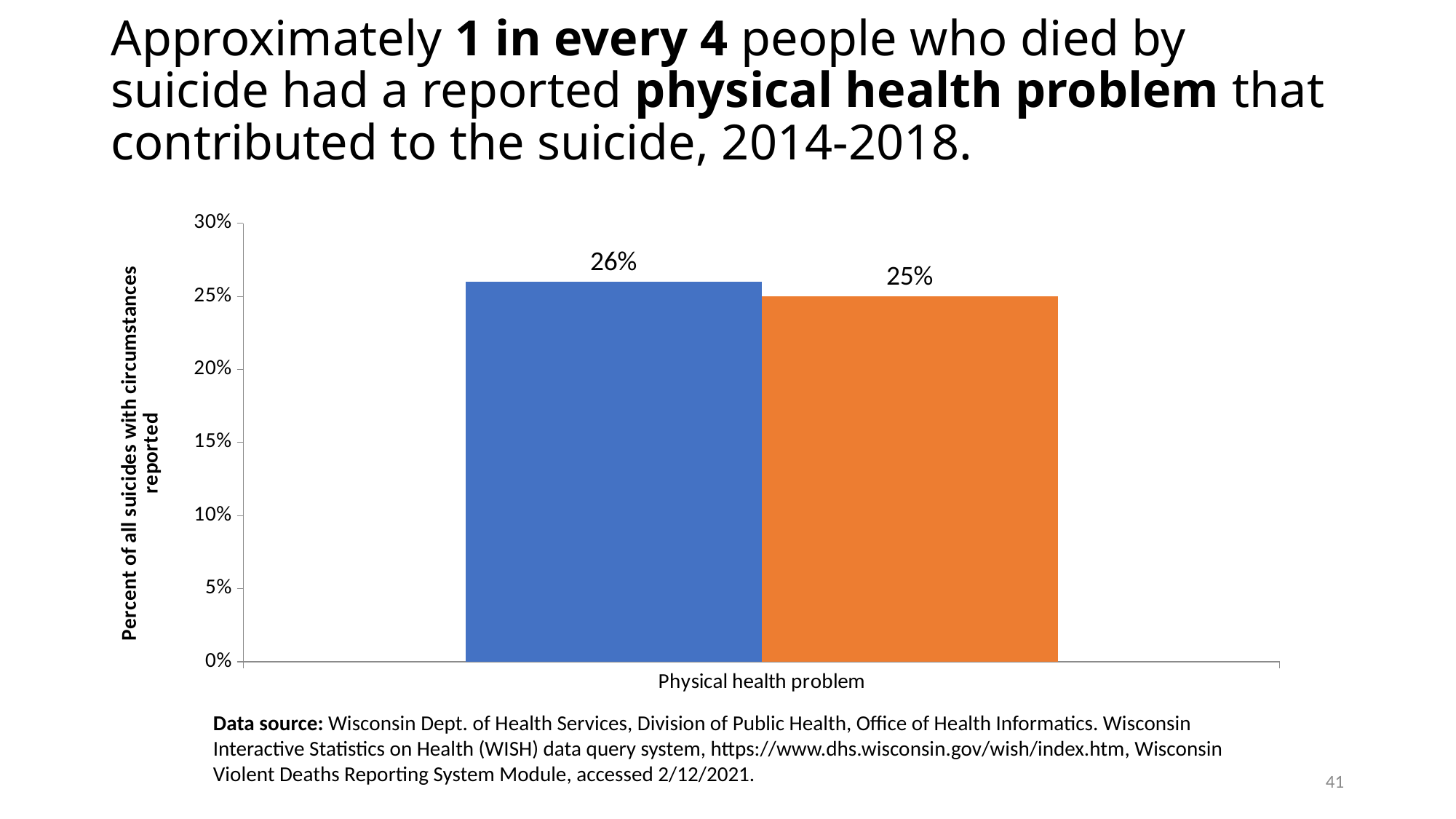
What is the difference between the blue bar (26%) and the orange bar (25%)? 1% Which bar has the highest value in the chart? The blue bar (26%) Which bar is taller, the blue bar or the orange bar? The blue bar What is the label on the y axis of the chart? Percent of all suicides with circumstances reported Which bar has the lowest value in the chart? The orange bar (25%) Is the value for the orange bar greater or less than 30%? less How many categories are shown on the x axis of the chart? 1 What kind of chart is shown on the slide? Bar chart How many bars are plotted in the chart? 2 What value is shown on the blue bar for Physical health problem? 26% What value is shown on the orange bar for Physical health problem? 25% Is the value for the blue bar greater or less than 20%? greater